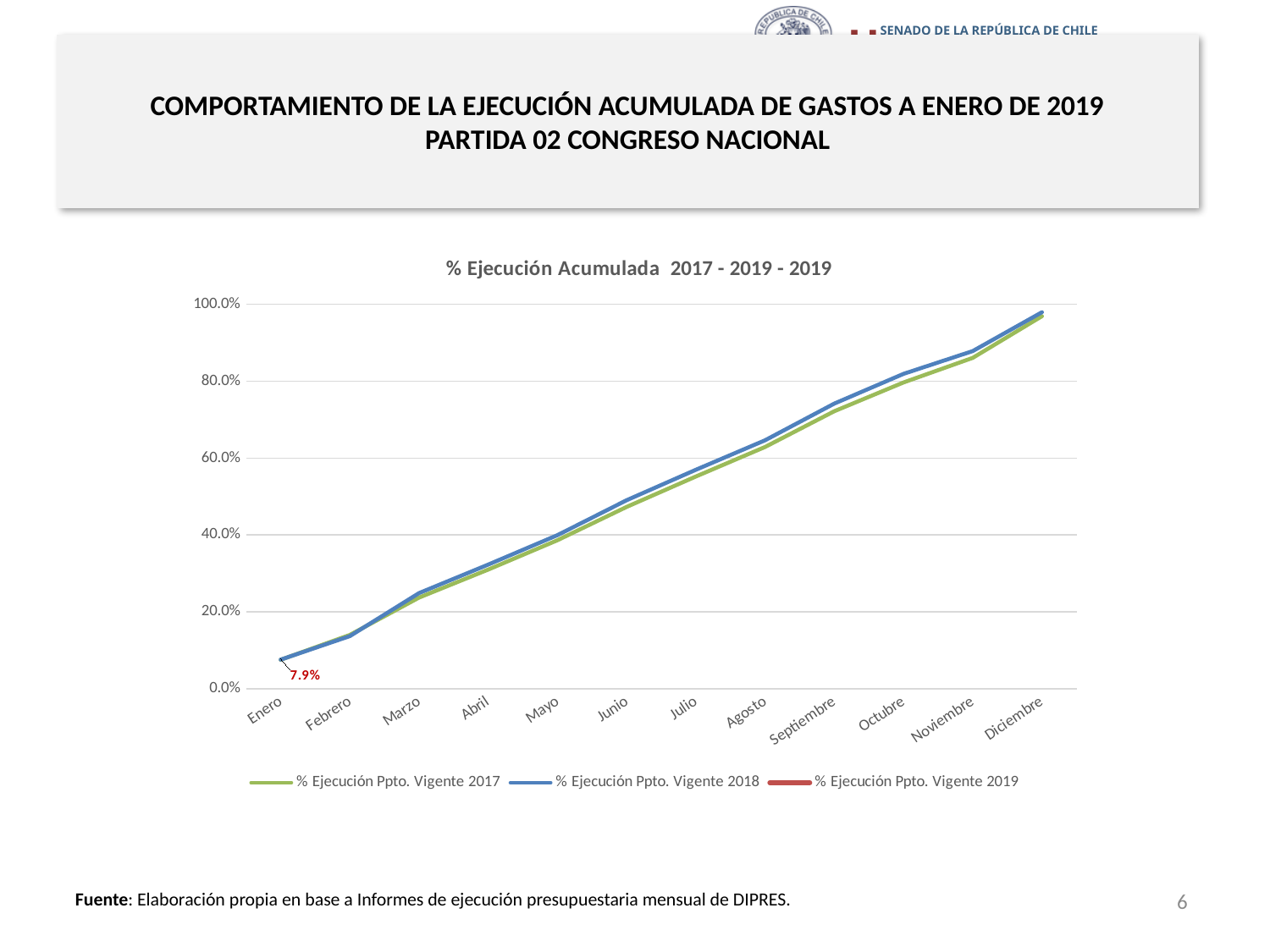
Do the values for % Ejecución Ppto. Vigente 2018 rise or fall from Enero to Diciembre? rise What kind of chart is shown on the slide? line chart Is the value for % Ejecución Ppto. Vigente 2017 in Marzo greater or less than 40.0%? less In which month is the value for % Ejecución Ppto. Vigente 2017 lowest? Enero What value is printed as a data label at Enero on the chart? 7.9% What is the title of the chart? % Ejecución Acumulada 2017 - 2019 - 2019 Which legend entry is shown in green? % Ejecución Ppto. Vigente 2017 In which month is the value for % Ejecución Ppto. Vigente 2018 highest? Diciembre Is the value for % Ejecución Ppto. Vigente 2018 in Septiembre greater or less than 60.0%? greater Is the value for % Ejecución Ppto. Vigente 2018 in Diciembre greater or less than 80.0%? greater How many series does the chart legend list? 3 How many months are shown along the x axis of the chart? 12